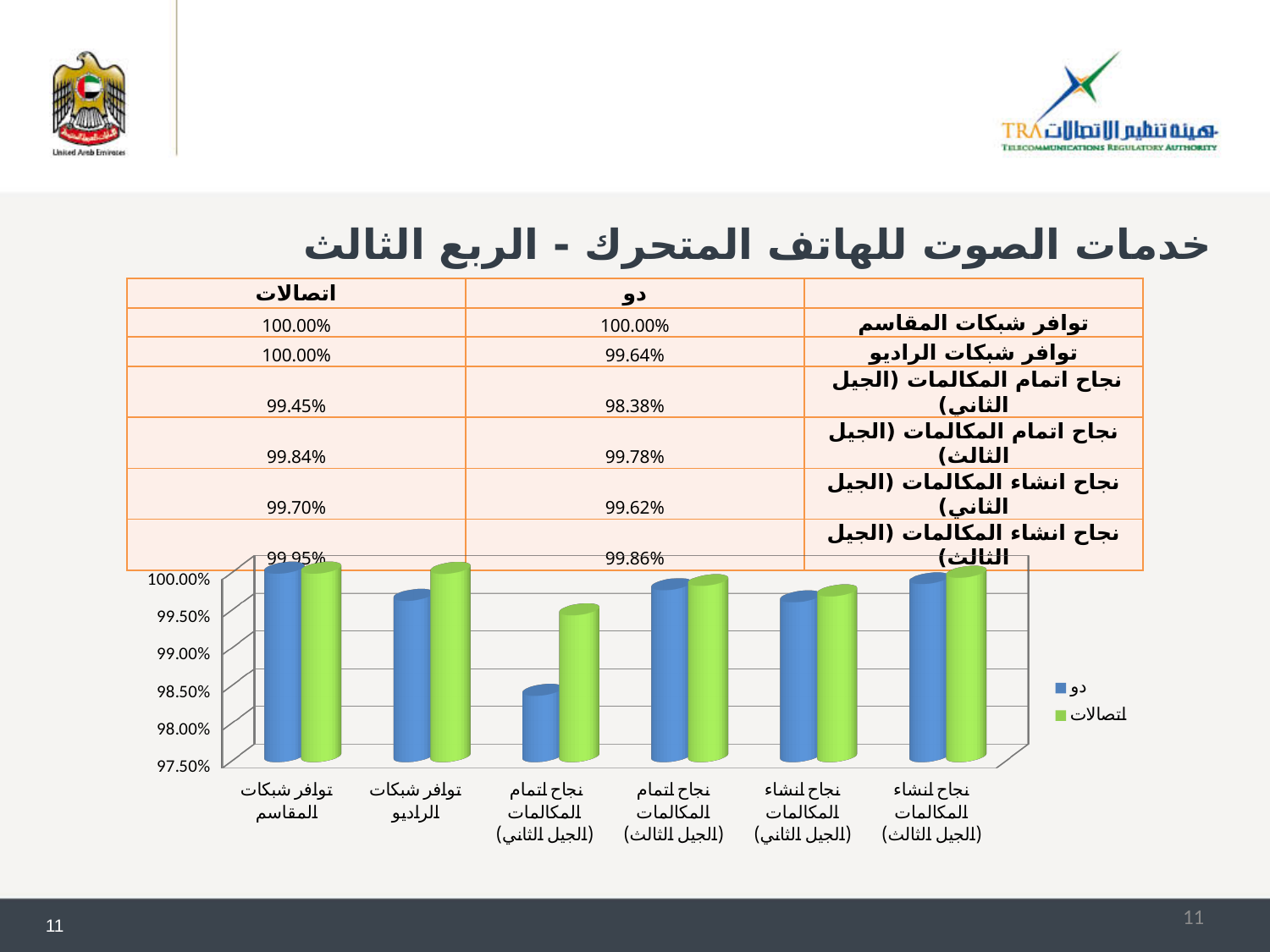
What is the value for دو in the category نجاح انشاء المكالمات (الجيل الثالث)? 99.86% Is the value for دو in the category نجاح اتمام المكالمات (الجيل الثاني) greater or less than 99.00%? less In which category does دو have its lowest value? نجاح اتمام المكالمات (الجيل الثاني) What type of chart is shown on the slide? bar chart What is the value for دو in the category نجاح اتمام المكالمات (الجيل الثاني)? 98.38% Which series has the larger value in the category توافر شبكات الراديو, دو or اتصالات? اتصالات How many categories are shown on the x axis of the chart? 6 What is the difference between اتصالات and دو in the category نجاح اتمام المكالمات (الجيل الثاني)? 1.07% Which two series are listed in the chart legend? دو and اتصالات Is the value for اتصالات in the category نجاح انشاء المكالمات (الجيل الثاني) greater or less than 99.50%? greater How many series does the chart legend list? 2 What is the value for اتصالات in the category توافر شبكات الراديو? 100.00%